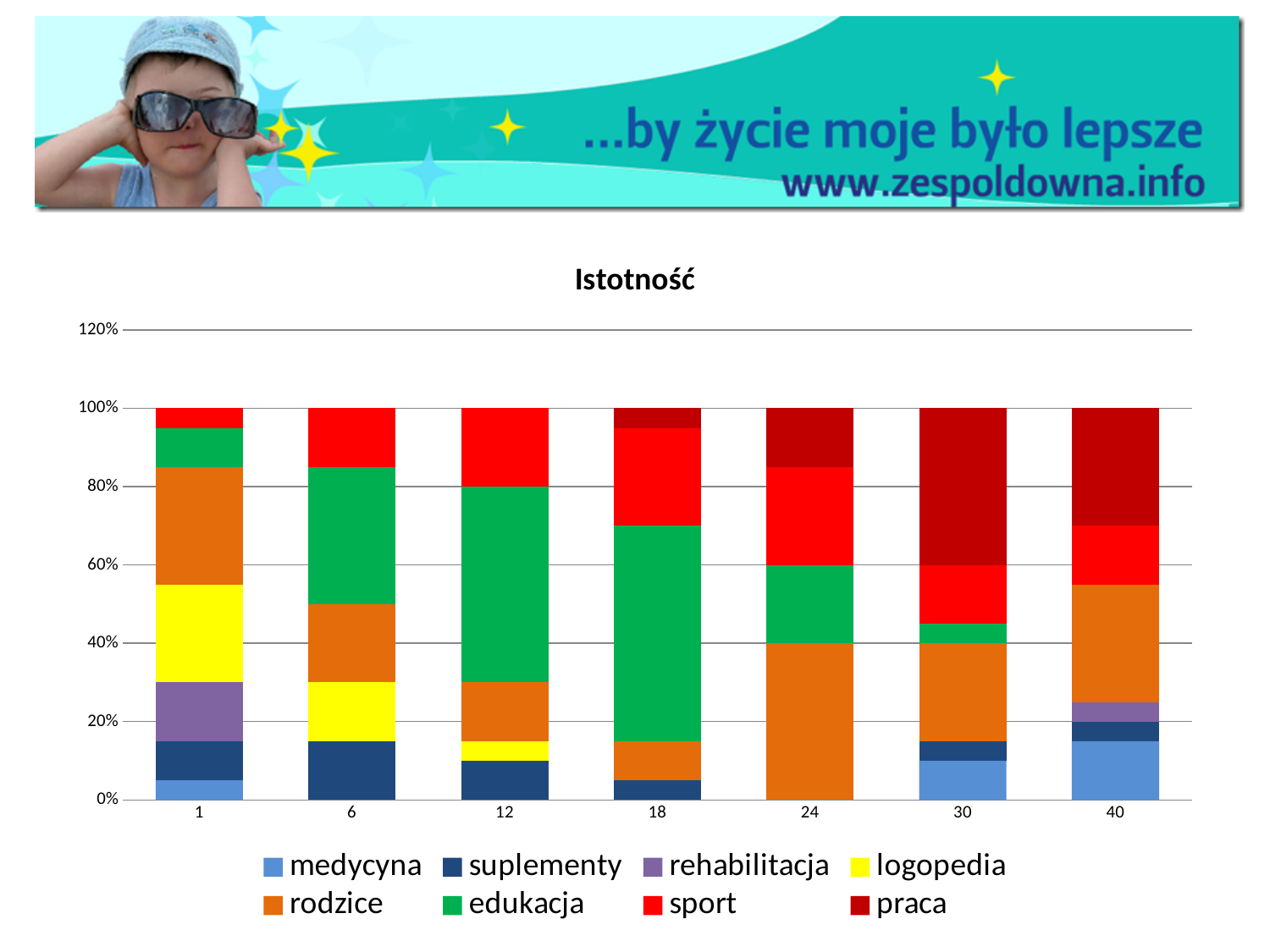
Is the edukacja segment larger for category 12 or for category 1? 12 Is the value of the edukacja segment for category 18 greater or less than 40%? greater How many categories are shown along the x axis of the chart? 7 What is the title of the chart? Istotność What kind of chart is shown on the slide? stacked bar chart Which category has the largest praca segment? 30 Which colour represents the sport series in the legend? red How many series does the legend list? 8 Is the value of the rodzice segment for category 24 greater or less than 20%? greater Is the value of the medycyna segment for category 1 greater or less than 20%? less Which category has the largest logopedia segment? 1 What is the total height of the stacked bar for category 6? 100%